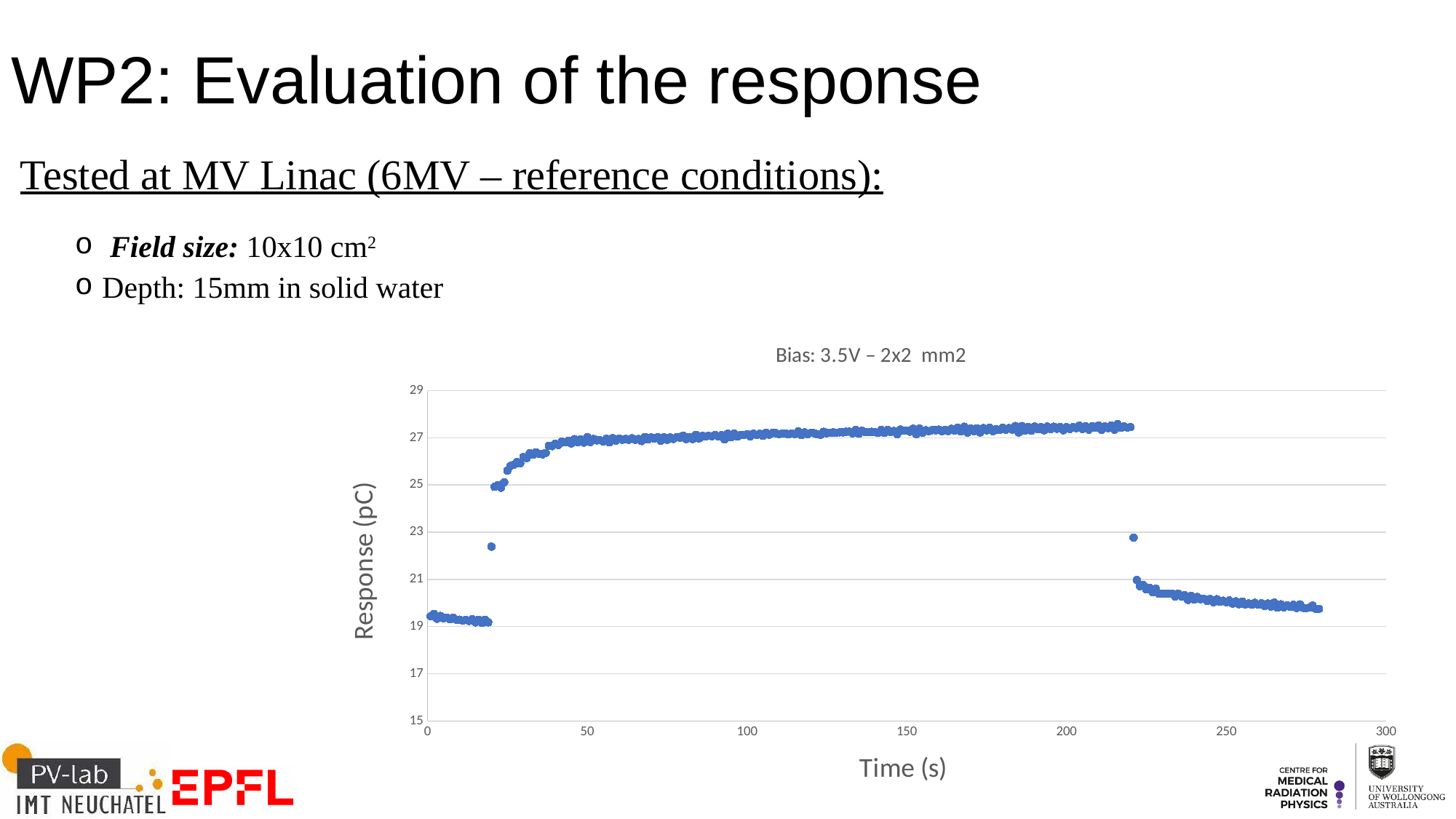
What is the highest tick value shown on the Time (s) axis? 300 What is the title of the chart? Bias: 3.5V – 2x2 mm2 Is the response value at around 10 s greater or less than 21? less Between about 50 s and 200 s, do the response values rise or fall along the time axis? rise Is the response value at around 250 s greater or less than 19? greater Is the response value at around 100 s greater or less than 25? greater Between about 230 s and 280 s, do the response values rise or fall along the time axis? fall What kind of chart is shown on the slide? scatter chart What is the label of the vertical axis of the chart? Response (pC) Is the response at around 100 s larger or smaller than the response at around 10 s? larger